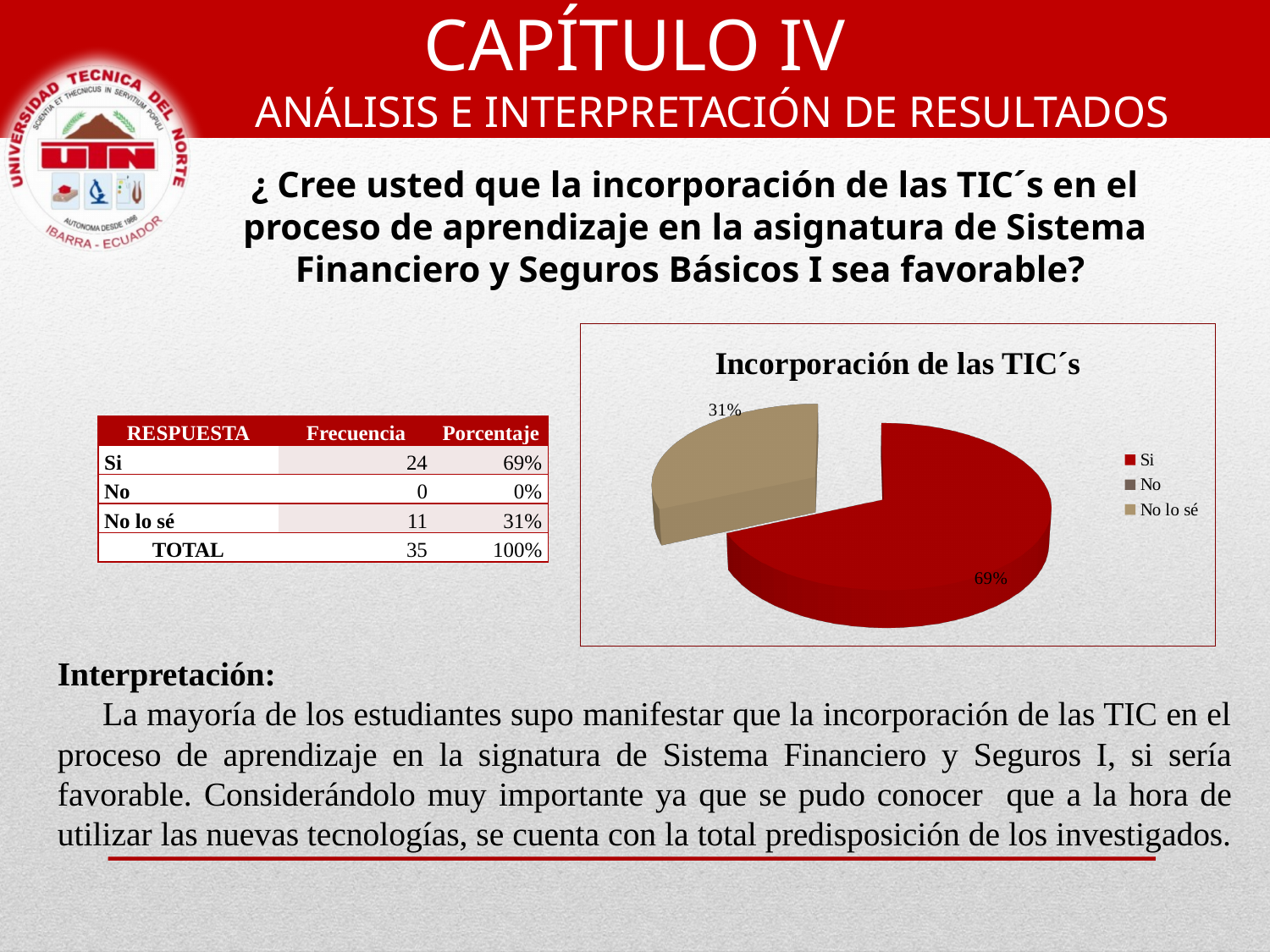
How many entries does the chart legend list? 3 What kind of chart is shown on the slide? pie chart Which category has the largest slice of the pie? Si Is the "Si" slice greater or less than 50% of the pie? greater What colour is the "Si" slice in the pie chart? red What is the difference in percentage points between the "Si" slice and the "No lo sé" slice? 38% Which is larger, the "Si" slice or the "No lo sé" slice? Si What percentage of the pie does the "Si" slice represent? 69% What percentage of the pie does the "No lo sé" slice represent? 31% What is the title of the chart? Incorporación de las TIC´s How many slices with a visible percentage label are shown in the pie chart? 2